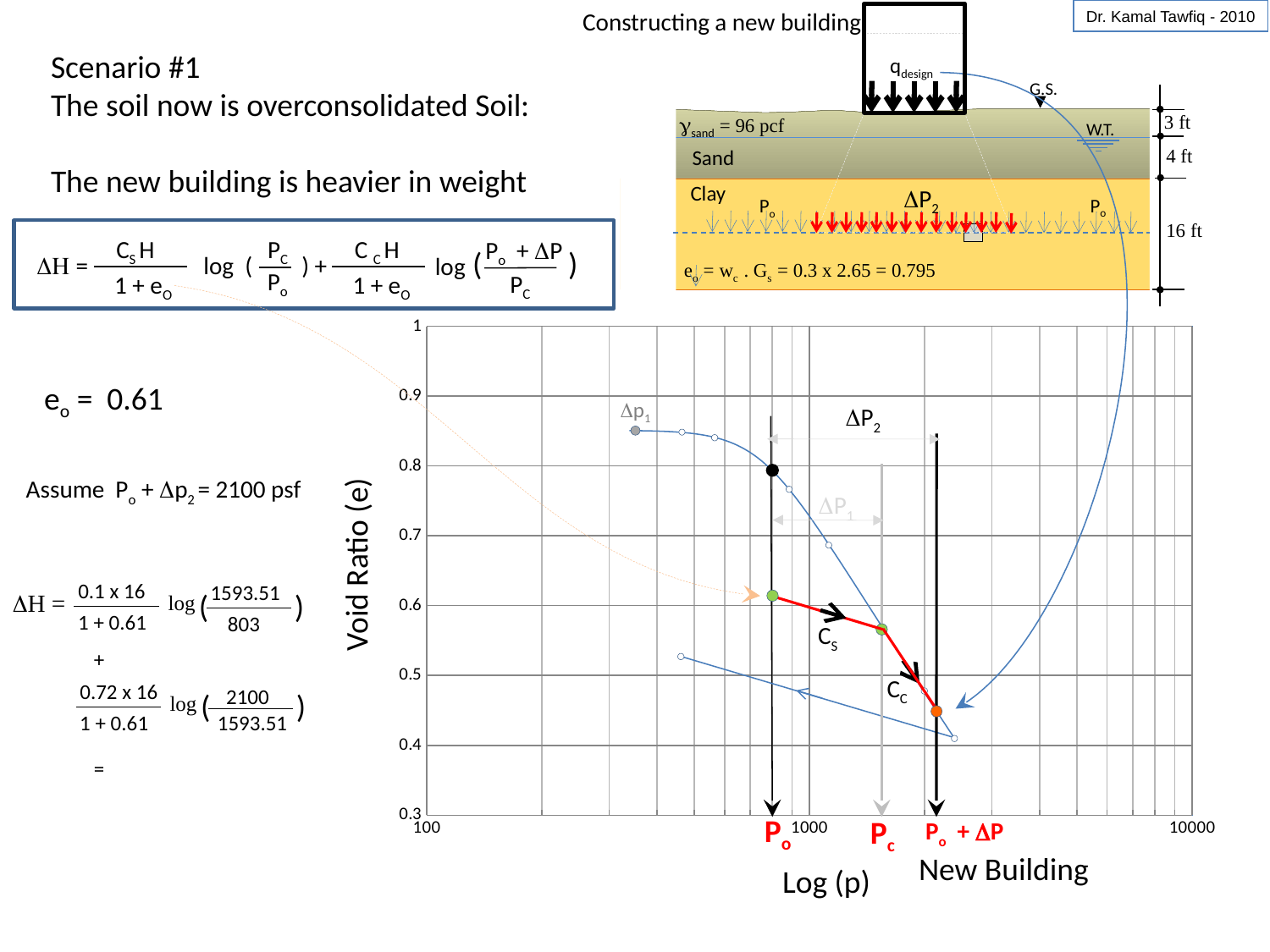
As pressure p increases along the horizontal axis, does the void ratio on the curve rise or fall? fall Is the void ratio of the point at Pc greater or less than 0.6? less What is the title of the vertical axis of the chart? Void Ratio (e) What is the largest value labelled on the horizontal axis of the chart? 10000 What is the title of the horizontal axis of the chart? Log (p) Which has the higher void ratio on the curve: the black point at Po or the point at Pc? the black point at Po What is the lowest value shown on the vertical axis of the chart? 0.3 Is the void ratio of the grey point labelled Δp1 greater or less than 0.8? greater Is the void ratio of the black point on the curve at Po greater or less than 0.7? greater What is the highest value shown on the vertical axis of the chart? 1 What kind of chart is shown on the slide? line chart